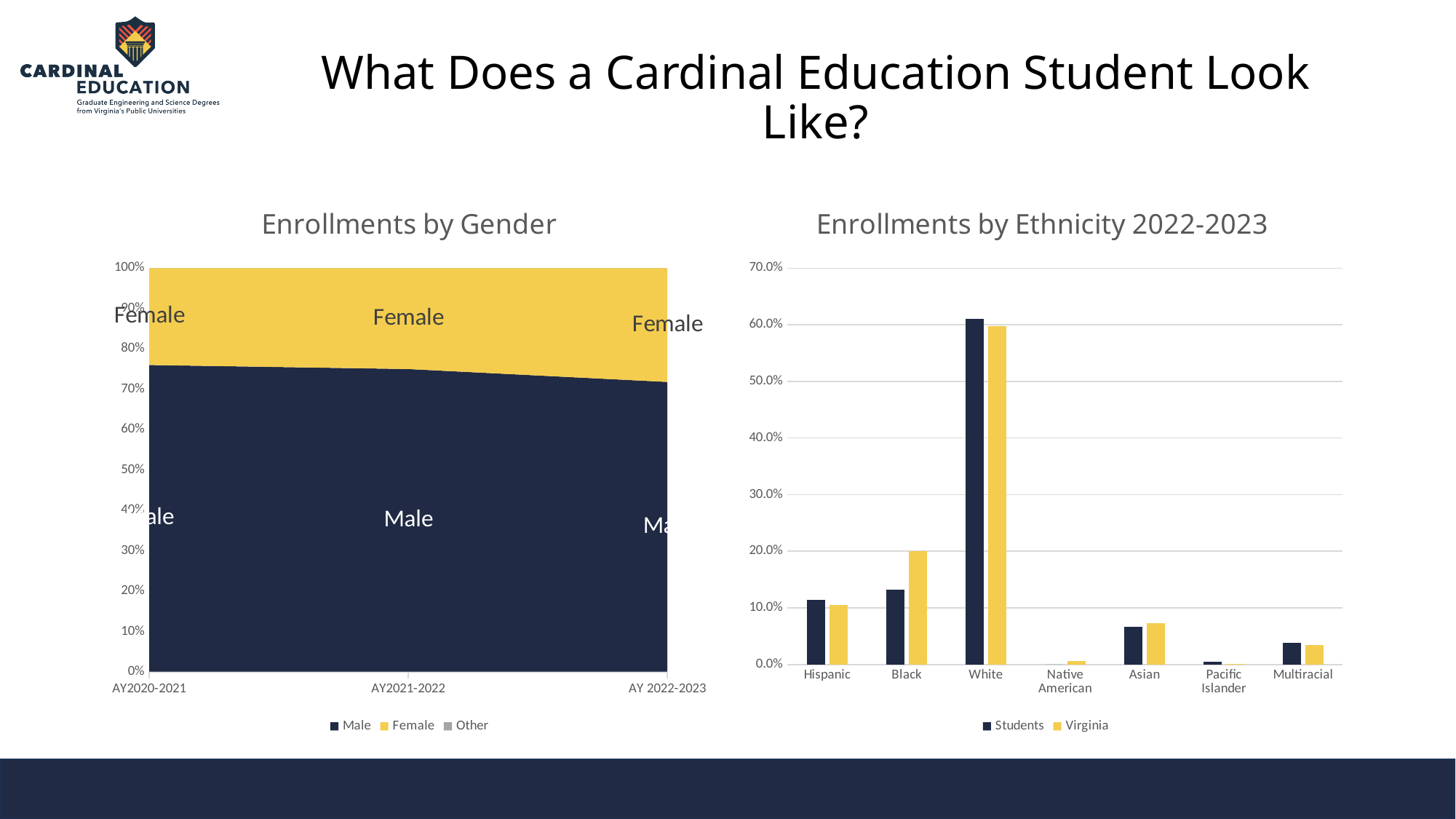
In the "Enrollments by Ethnicity 2022-2023" chart, is the Students value for White greater or less than 50.0%? greater What kind of chart is the "Enrollments by Ethnicity 2022-2023" chart? bar chart In the "Enrollments by Ethnicity 2022-2023" chart, for Black, which is larger: the Students value or the Virginia value? Virginia How many entries does the legend of the "Enrollments by Gender" chart list? 3 In the "Enrollments by Gender" chart, does the Male share rise or fall from AY2020-2021 to AY 2022-2023? fall In the "Enrollments by Ethnicity 2022-2023" chart, is the Students value for Asian greater or less than 10.0%? less How many academic years are shown on the x axis of the "Enrollments by Gender" chart? 3 In the "Enrollments by Gender" chart, is the Male share in AY2021-2022 greater or less than 50%? greater In the "Enrollments by Ethnicity 2022-2023" chart, which ethnicity has the highest Students value? White How many series does the legend of the "Enrollments by Ethnicity 2022-2023" chart list? 2 How many ethnicity categories are shown on the x axis of the "Enrollments by Ethnicity 2022-2023" chart? 7